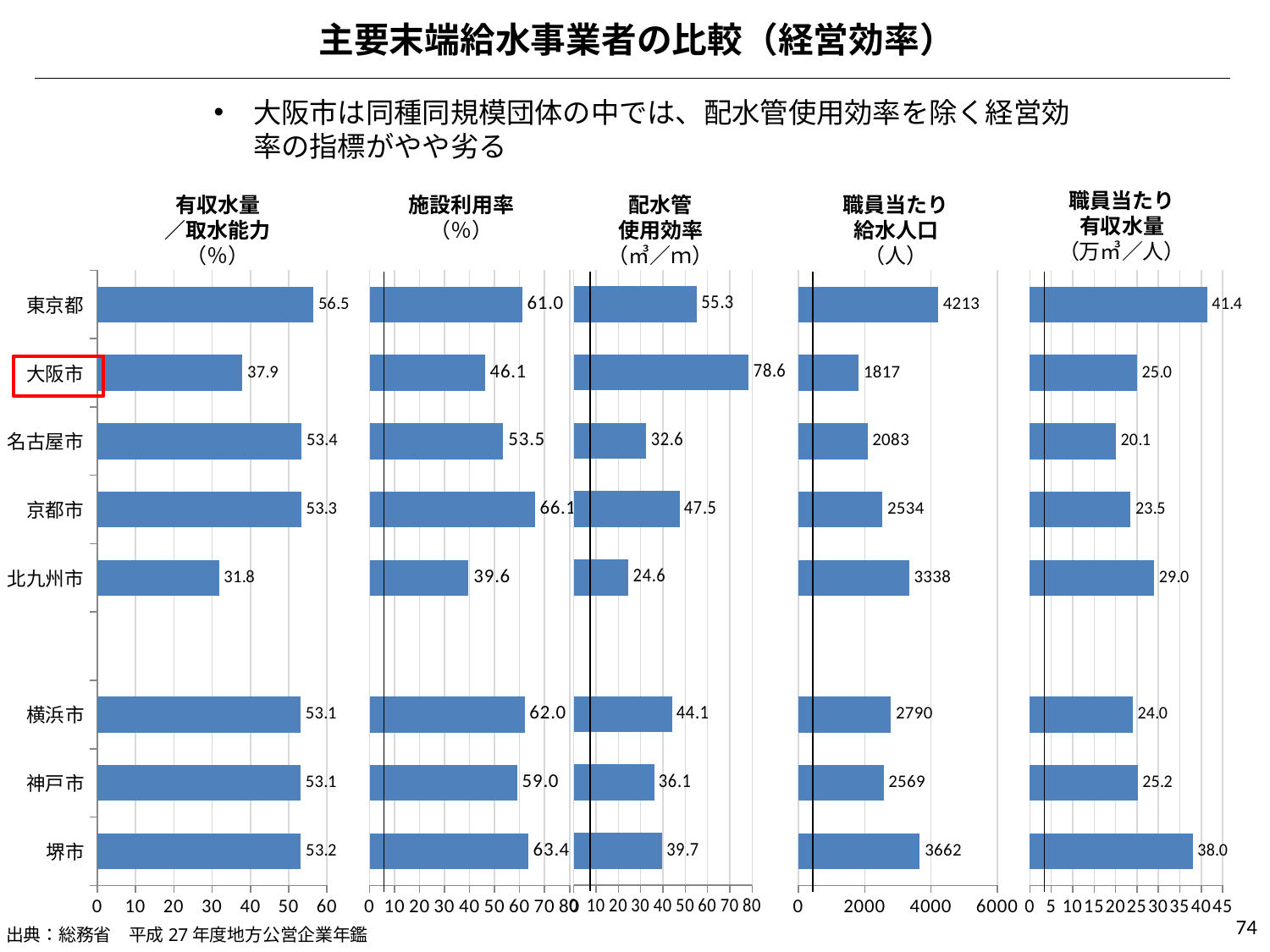
In the 職員当たり有収水量 chart, what is the value for 東京都? 41.4 How many separate charts are shown on the slide? 5 In the 職員当たり有収水量 chart, what is the difference between 堺市 and 名古屋市? 17.9 What type of chart is used for 職員当たり有収水量? bar chart In the 配水管使用効率 chart, what is the value for 大阪市? 78.6 In the 施設利用率 (%) chart, which city has the highest value? 京都市 How many cities/entities are shown in the 有収水量／取水能力 (%) chart? 8 In the 配水管使用効率 chart, which city has the lowest value? 北九州市 In the 有収水量／取水能力 (%) chart, what is the value for 大阪市? 37.9 In the 施設利用率 (%) chart, which is larger, 横浜市 or 神戸市? 横浜市 In the 職員当たり給水人口 (人) chart, which entity has the lowest value? 大阪市 In the 職員当たり給水人口 (人) chart, what is the difference between 東京都 and 大阪市? 2396